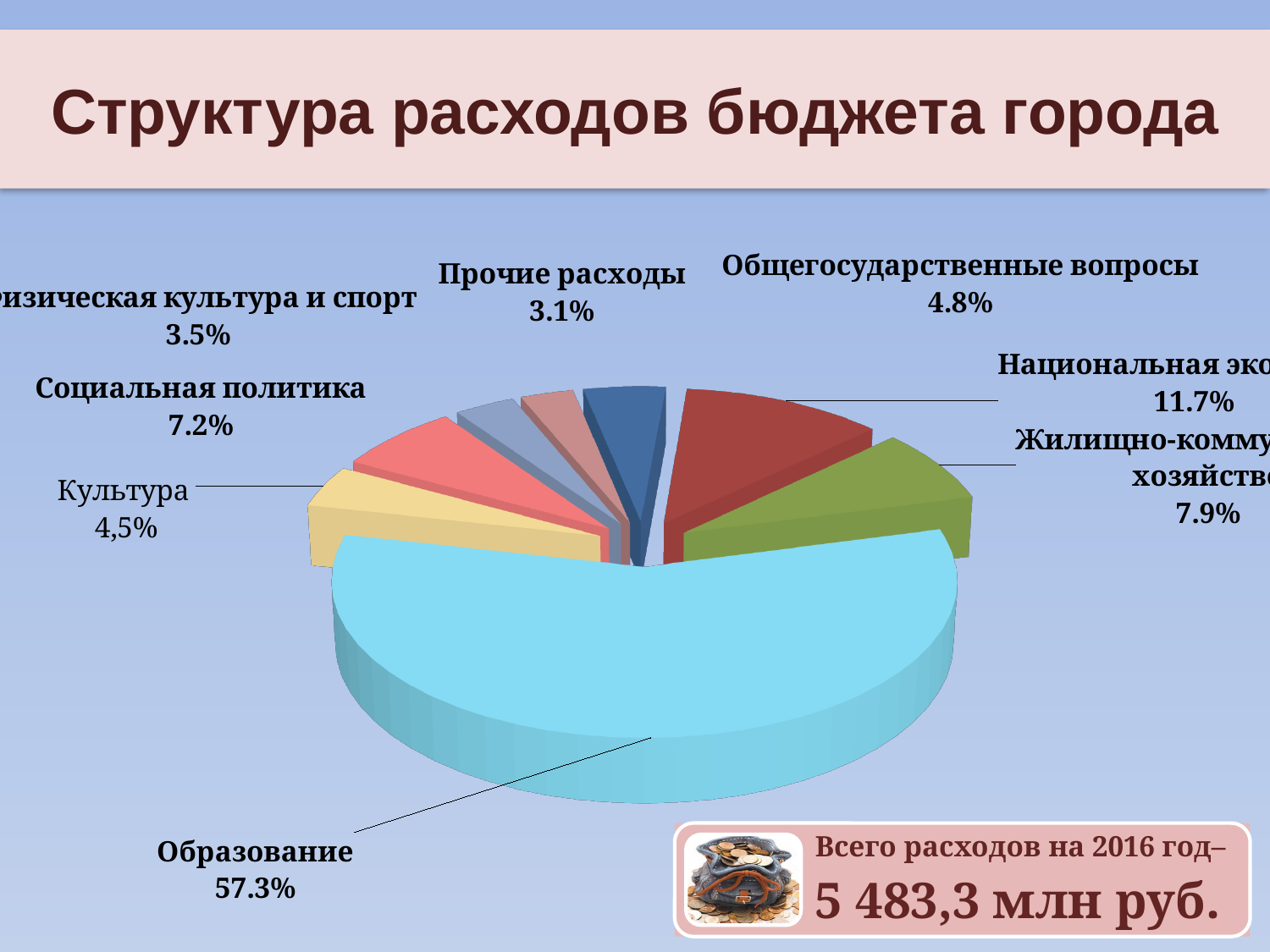
Which category has the smallest share of the pie? Прочие расходы What share of the city budget expenditures goes to Образование? 57.3% What is the value shown for Прочие расходы? 3.1% What is the value shown for Культура? 4,5% What is the value shown for Общегосударственные вопросы? 4.8% Which category has the largest share of the pie? Образование How many slices does the pie chart have? 8 What kind of chart is shown on the slide? pie chart What is the value shown for Социальная политика? 7.2% What is the title of the slide? Структура расходов бюджета города Which is larger, the share for Культура or the share for Физическая культура и спорт? Культура What is the difference in percentage points between Социальная политика and Общегосударственные вопросы? 2.4